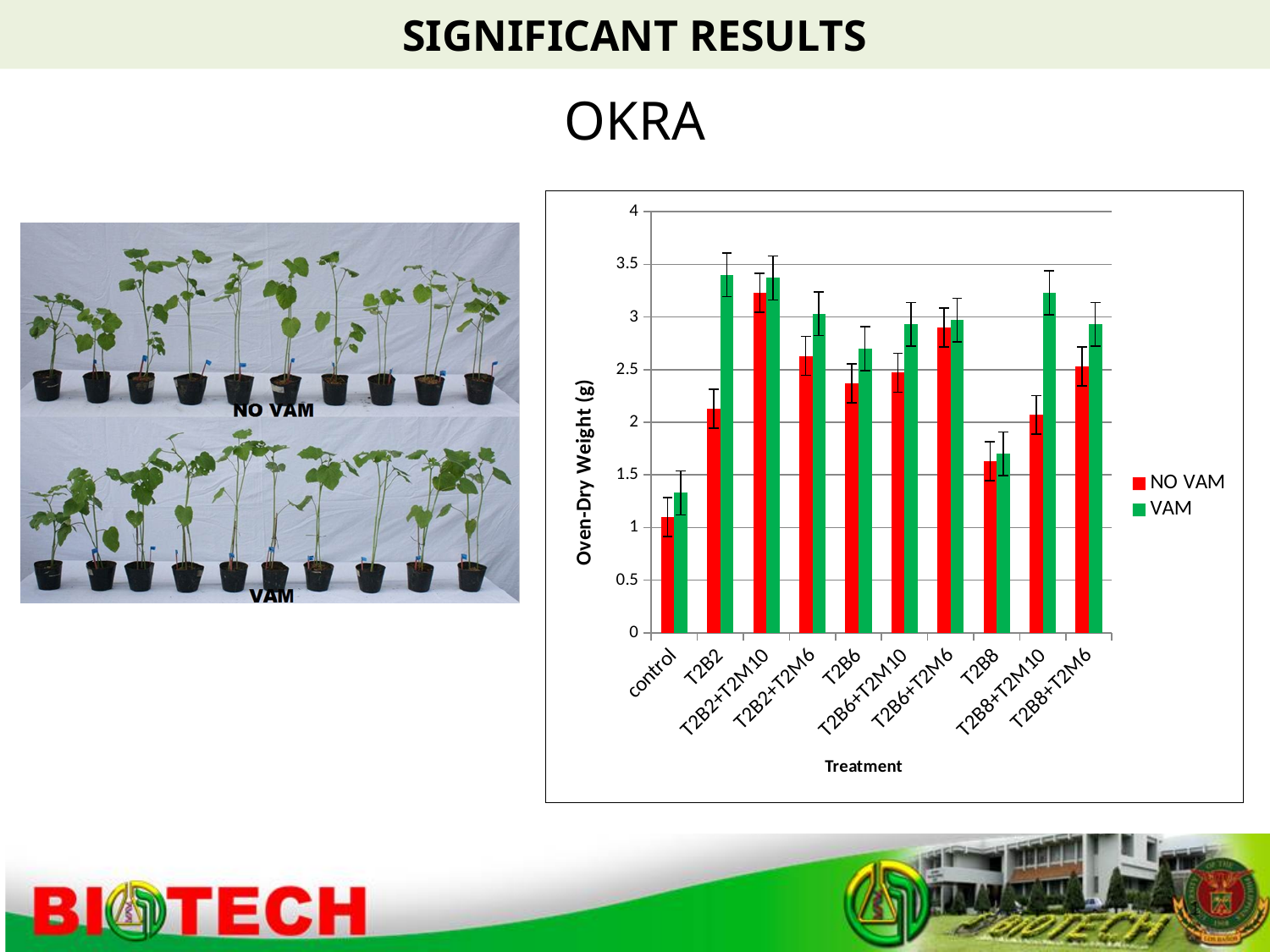
Is the VAM value for T2B8+T2M10 greater or less than 3? greater How many series does the chart legend list? 2 How many treatment categories are shown on the x axis of the chart? 10 Which treatment has the highest NO VAM oven-dry weight? T2B2+T2M10 Is the NO VAM value for T2B8 greater or less than 2? less Is the VAM value for T2B2 greater or less than 3? greater Which treatment has the lowest NO VAM oven-dry weight? control What kind of chart is shown on the slide? bar chart Which treatment has the lowest VAM oven-dry weight? control For T2B2, which is larger: the NO VAM value or the VAM value? VAM What is the label of the y axis of the chart? Oven-Dry Weight (g)